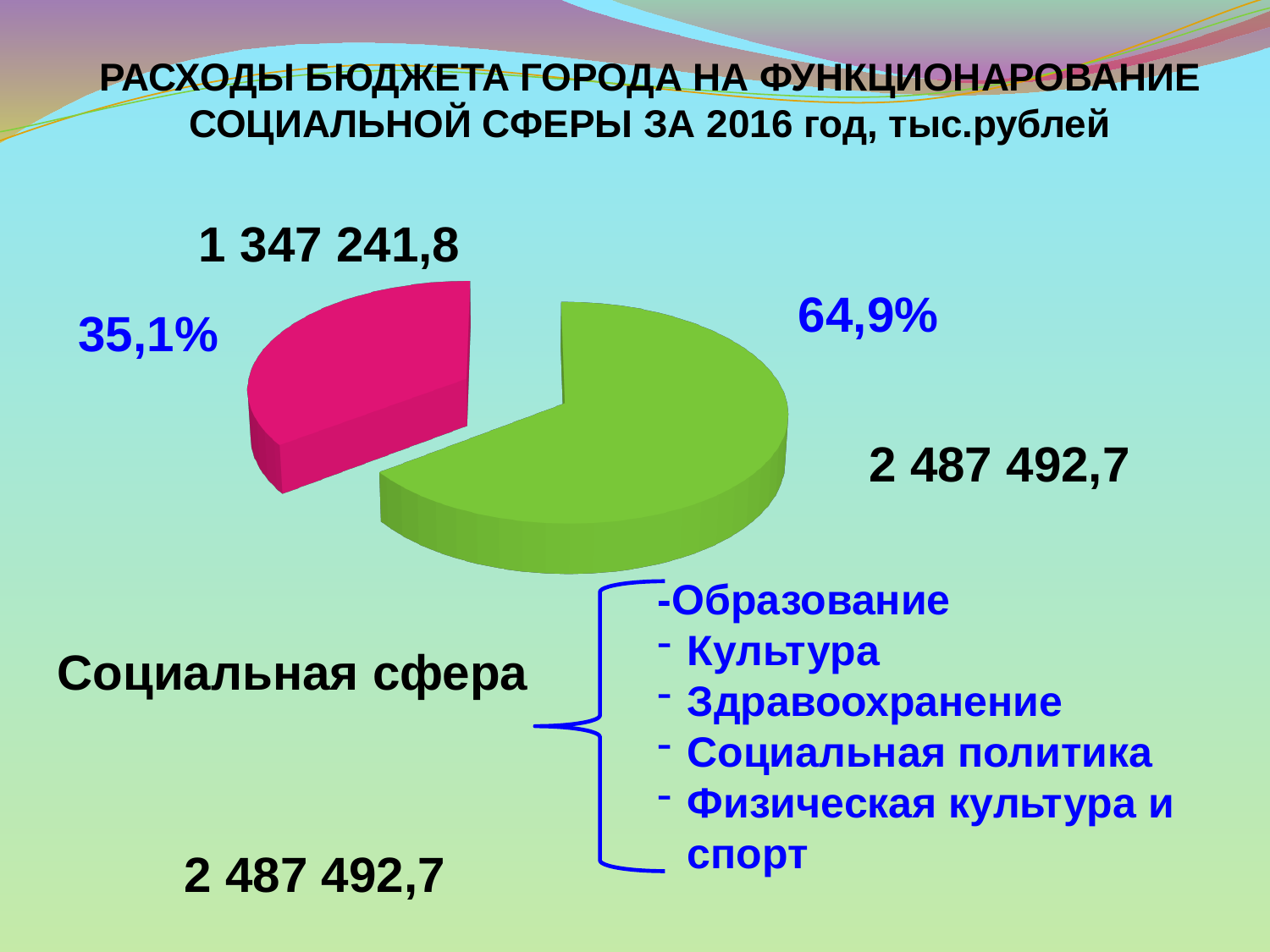
What value is shown for Социальная сфера? 2 487 492,7 What share of the pie does the pink slice represent? 35,1% What value is labelled on the green slice of the pie chart? 2 487 492,7 What is the difference between the value of the green slice and the value of the pink slice? 1 140 250,9 Which slice of the pie chart is the smallest? the pink slice (35,1%) How many slices does the pie chart have? 2 What value is labelled on the pink slice of the pie chart? 1 347 241,8 What share of the pie does the green slice represent? 64,9% Which slice of the pie chart is the largest? the green slice (64,9%) What is the title of the chart on the slide? РАСХОДЫ БЮДЖЕТА ГОРОДА НА ФУНКЦИОНАРОВАНИЕ СОЦИАЛЬНОЙ СФЕРЫ ЗА 2016 год, тыс.рублей What kind of chart is shown on the slide? pie chart Which is larger, the green slice or the pink slice? the green slice